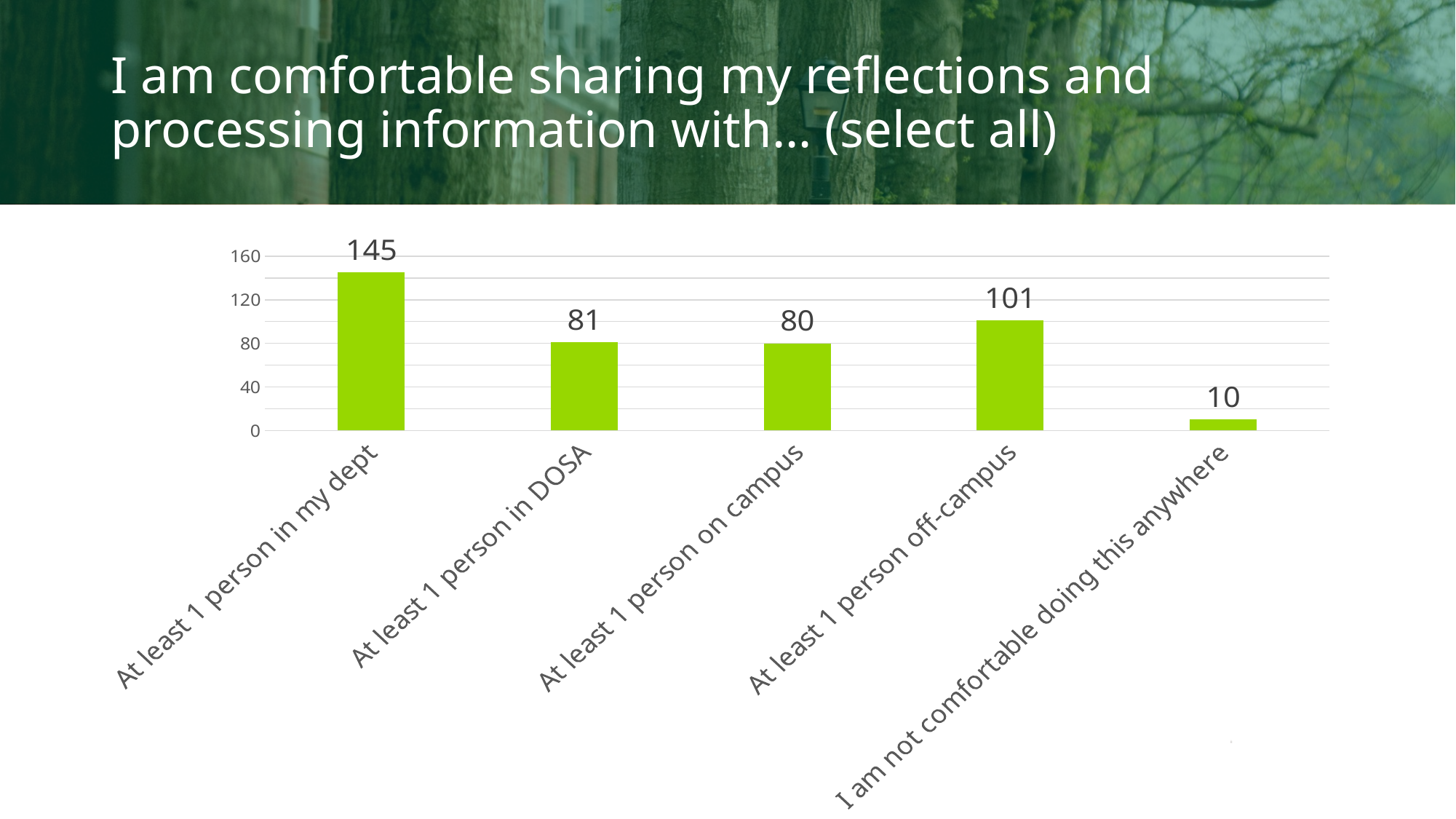
What is the value for 'At least 1 person in my dept'? 145 What is the title of the slide? I am comfortable sharing my reflections and processing information with… (select all) What is the difference between the values for 'At least 1 person in my dept' and 'At least 1 person off-campus'? 44 What is the value for 'At least 1 person off-campus'? 101 What is the value for 'I am not comfortable doing this anywhere'? 10 What is the value for 'At least 1 person in DOSA'? 81 Which category has the highest value? At least 1 person in my dept Which category has the lowest value? I am not comfortable doing this anywhere Is the value for 'At least 1 person in DOSA' greater or less than 120? less How many categories are shown in the chart? 5 Which is larger: the value for 'At least 1 person off-campus' or 'At least 1 person on campus'? At least 1 person off-campus What kind of chart is shown on the slide? Bar chart